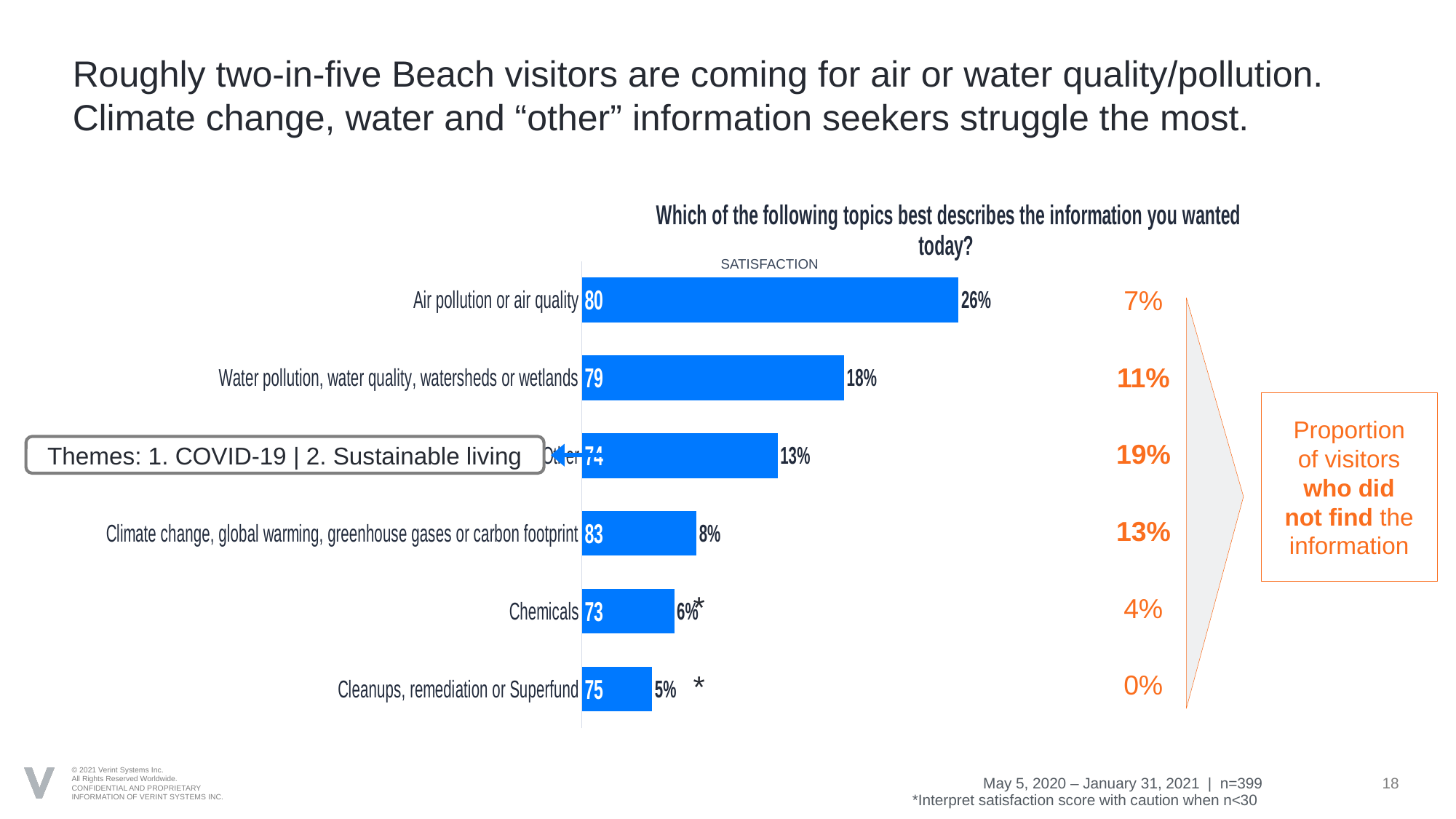
What percentage of visitors wanted information on water pollution, water quality, watersheds or wetlands? 18% What proportion of visitors seeking climate change, global warming, greenhouse gases or carbon footprint information did not find the information? 13% How many topic categories are shown in the bar chart? 6 Which has a higher satisfaction score, Chemicals or Cleanups, remediation or Superfund? Cleanups, remediation or Superfund What kind of chart is shown on the slide? bar chart What is the satisfaction score for Chemicals? 73 What is the difference in percentage points between air pollution or air quality and water pollution, water quality, watersheds or wetlands? 8 Which topic has the lowest percentage of visitors? Cleanups, remediation or Superfund What percentage of visitors wanted information on cleanups, remediation or Superfund? 5% Which topic has the highest percentage of visitors? Air pollution or air quality What percentage of visitors wanted information on air pollution or air quality? 26% What is the satisfaction score for climate change, global warming, greenhouse gases or carbon footprint? 83